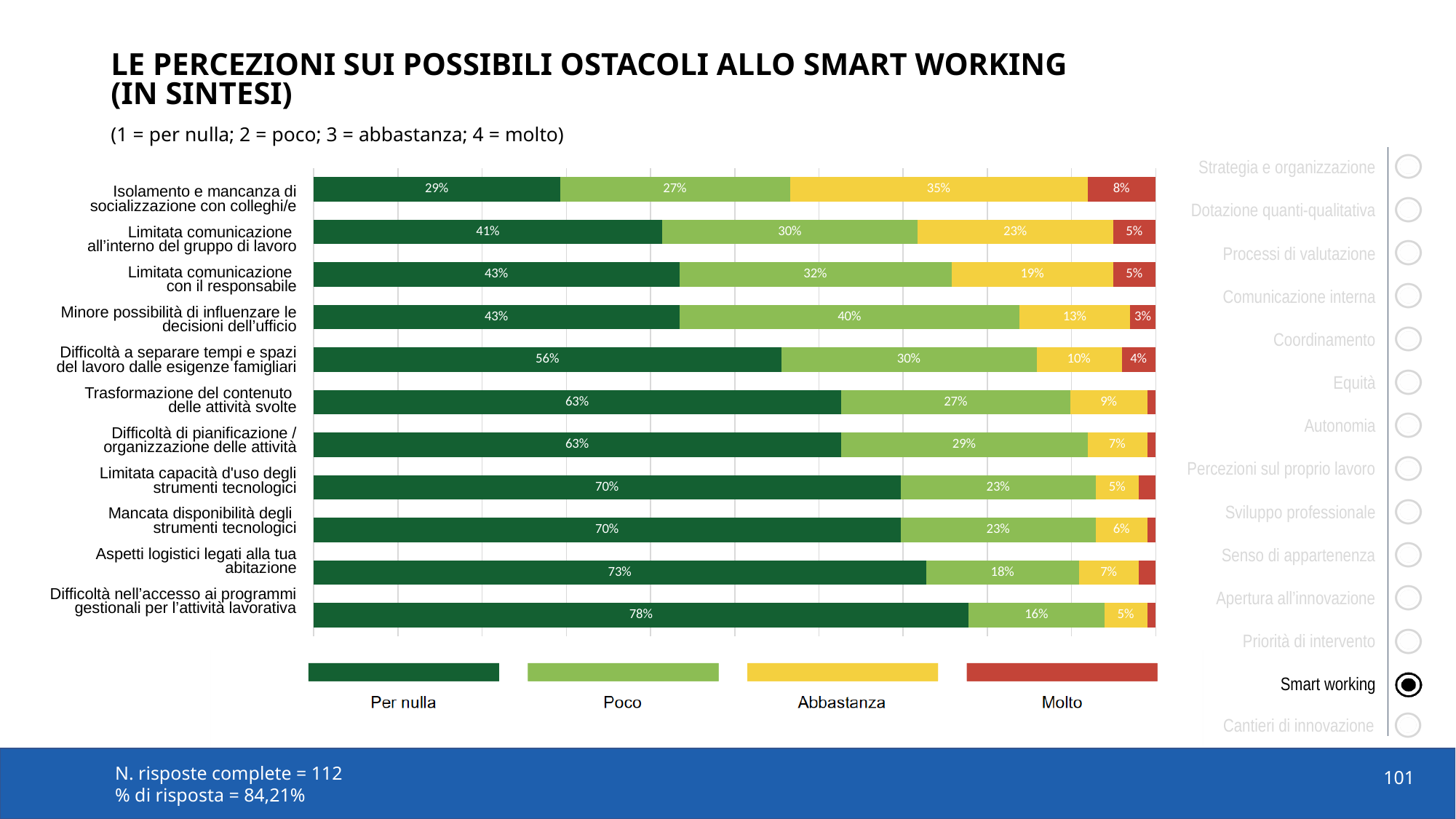
What kind of chart is shown on the slide? Stacked bar chart What is the "Abbastanza" value for "Isolamento e mancanza di socializzazione con colleghi/e"? 35% How many categories (obstacles) are shown in the chart? 11 Which category has the highest "Per nulla" percentage? Difficoltà nell'accesso ai programmi gestionali per l'attività lavorativa Which category has the lowest "Per nulla" percentage? Isolamento e mancanza di socializzazione con colleghi/e How many series does the legend list? 4 What is the "Poco" value for "Aspetti logistici legati alla tua abitazione"? 18% What percentage of respondents answered "Per nulla" for "Isolamento e mancanza di socializzazione con colleghi/e"? 29% Which has a larger "Poco" value: "Minore possibilità di influenzare le decisioni dell'ufficio" or "Limitata comunicazione con il responsabile"? Minore possibilità di influenzare le decisioni dell'ufficio Which category has the highest "Abbastanza" percentage? Isolamento e mancanza di socializzazione con colleghi/e What is the "Molto" value for "Limitata comunicazione con il responsabile"? 5% What is the difference in the "Per nulla" percentage between "Difficoltà nell'accesso ai programmi gestionali per l'attività lavorativa" and "Isolamento e mancanza di socializzazione con colleghi/e"? 49 percentage points